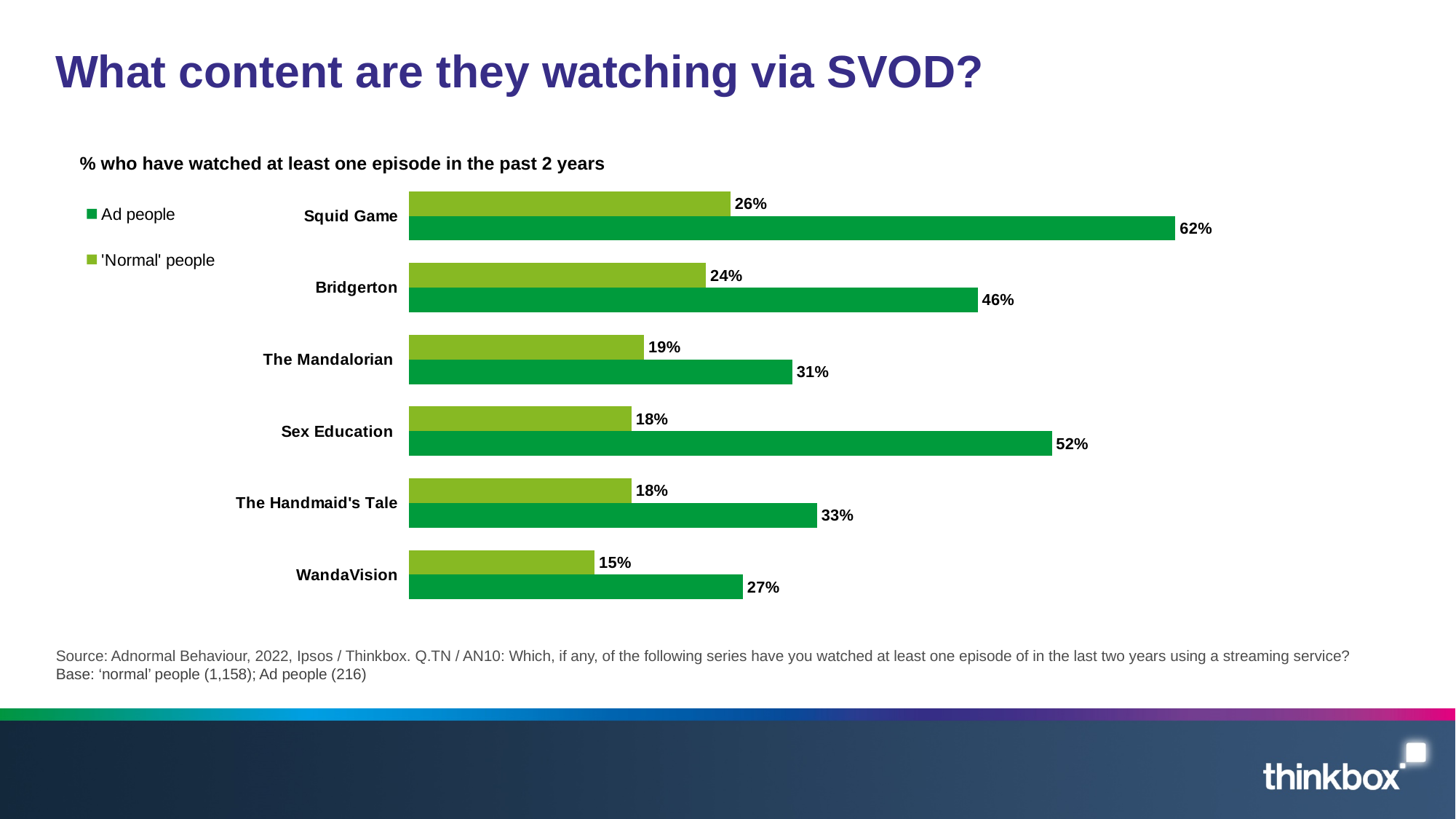
How many series does the legend list? 2 Which is larger: the Ad people value for Bridgerton or the Ad people value for The Mandalorian? Bridgerton How many series are shown on the chart? 6 What is the value for Ad people for Sex Education? 52% What is the difference between the Ad people values for Sex Education and The Handmaid's Tale? 19 percentage points Which series has the highest value for Ad people? Squid Game What is the subtitle of the chart? % who have watched at least one episode in the past 2 years Which series has the lowest value for 'Normal' people? WandaVision What percentage of Ad people have watched at least one episode of Squid Game? 62% What percentage of 'Normal' people have watched at least one episode of Bridgerton? 24% What is the difference between Ad people and 'Normal' people for Squid Game? 36 percentage points What kind of chart is shown on the slide? Bar chart